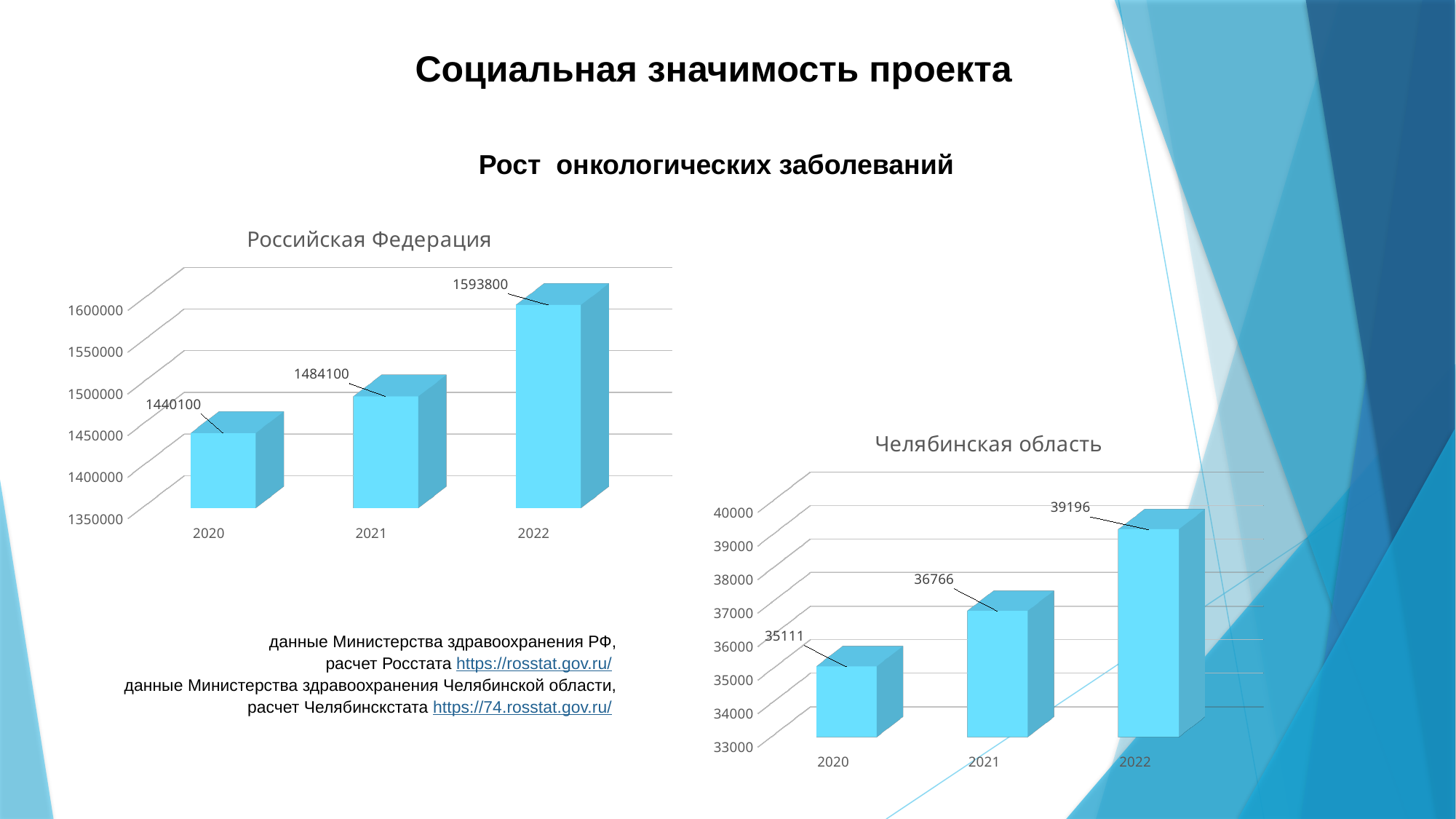
In the "Челябинская область" chart, what is the value for 2021? 36766 How many years are shown in the "Российская Федерация" chart? 3 In the "Российская Федерация" chart, what is the difference between the 2022 and 2021 values? 109700 What kind of chart is the "Челябинская область" chart? bar chart In the "Российская Федерация" chart, what is the value for 2020? 1440100 In the "Российская Федерация" chart, which year has the highest value? 2022 In the "Челябинская область" chart, which year has the lowest value? 2020 In the "Челябинская область" chart, which is larger, the value for 2020 or the value for 2022? 2022 In the "Российская Федерация" chart, do the values rise or fall from 2020 to 2022? rise In the "Челябинская область" chart, what is the value for 2022? 39196 In the "Челябинская область" chart, what is the difference between the 2021 and 2020 values? 1655 In the "Российская Федерация" chart, what is the value for 2022? 1593800